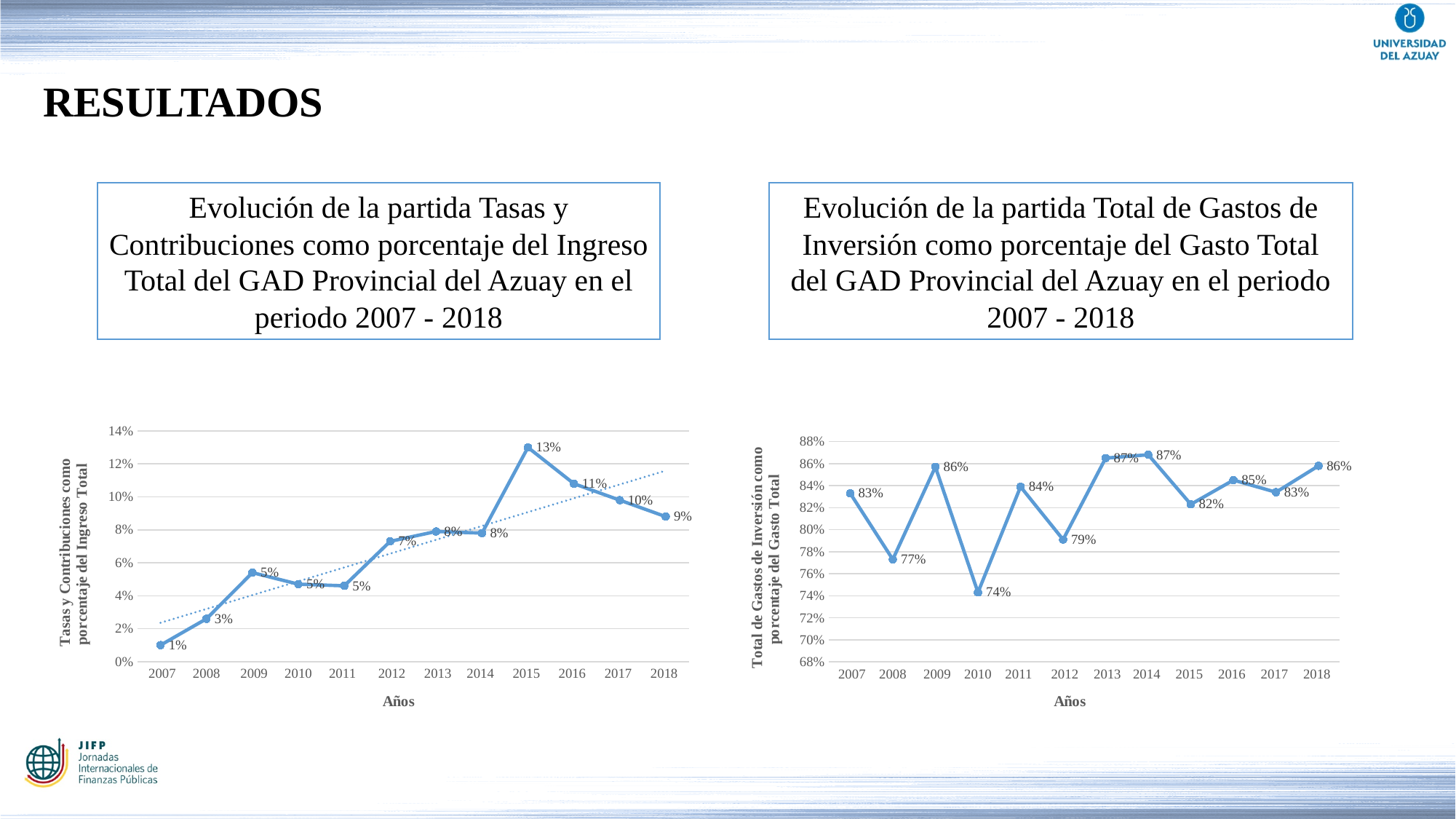
In the left chart (Tasas y Contribuciones), what is the difference between the values for 2015 and 2018? 4% In the left chart (Tasas y Contribuciones), what is the value for 2008? 3% In the left chart (Tasas y Contribuciones), which year has the lowest value? 2007 In the right chart (Total de Gastos de Inversión), which is larger, the value for 2009 or the value for 2012? 2009 What kind of chart is the right chart (Total de Gastos de Inversión)? Line chart In the right chart (Total de Gastos de Inversión), what is the difference between the values for 2007 and 2008? 6% In the right chart (Total de Gastos de Inversión), what is the value for 2010? 74% In the left chart (Tasas y Contribuciones), which year has the highest value? 2015 In the right chart (Total de Gastos de Inversión), which year has the lowest value? 2010 In the left chart (Tasas y Contribuciones), how many years are plotted on the x axis? 12 In the left chart (Tasas y Contribuciones), what is the value for 2015? 13% In the right chart (Total de Gastos de Inversión), what is the value for 2018? 86%